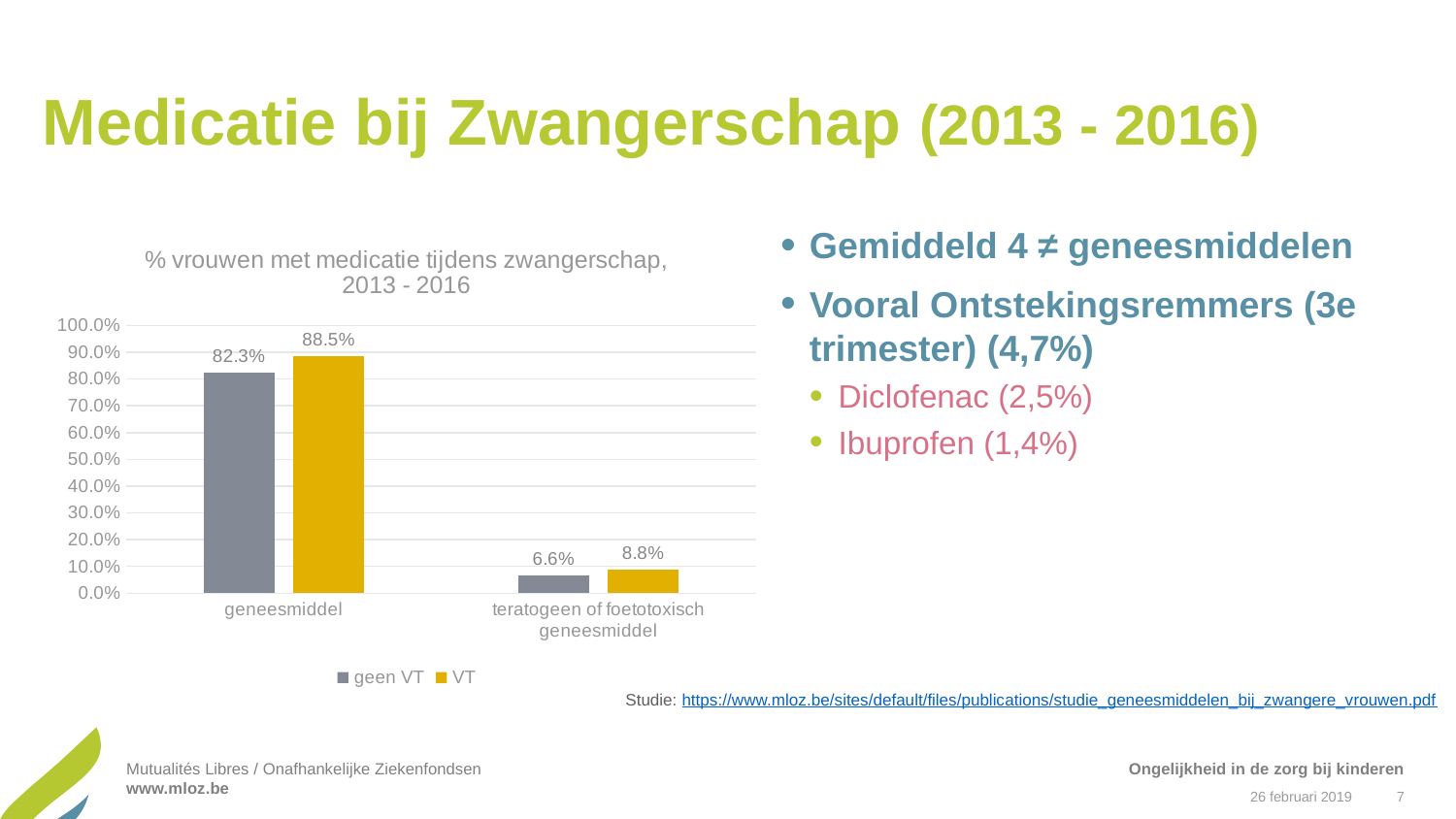
What type of chart is shown on the slide? Bar chart How many categories are shown on the x axis of the chart? 2 What is the value for geen VT in the teratogeen of foetotoxisch geneesmiddel category? 6.6% What is the value for VT in the geneesmiddel category? 88.5% What is the value for geen VT in the geneesmiddel category? 82.3% In the teratogeen of foetotoxisch geneesmiddel category, which is larger: geen VT or VT? VT How many series does the chart legend list? 2 What is the difference between the VT and geen VT values in the geneesmiddel category? 6.2 percentage points What is the difference between the VT and geen VT values in the teratogeen of foetotoxisch geneesmiddel category? 2.2 percentage points Which bar has the lowest value in the chart? geen VT, teratogeen of foetotoxisch geneesmiddel Which bar has the highest value in the chart? VT, geneesmiddel What is the value for VT in the teratogeen of foetotoxisch geneesmiddel category? 8.8%